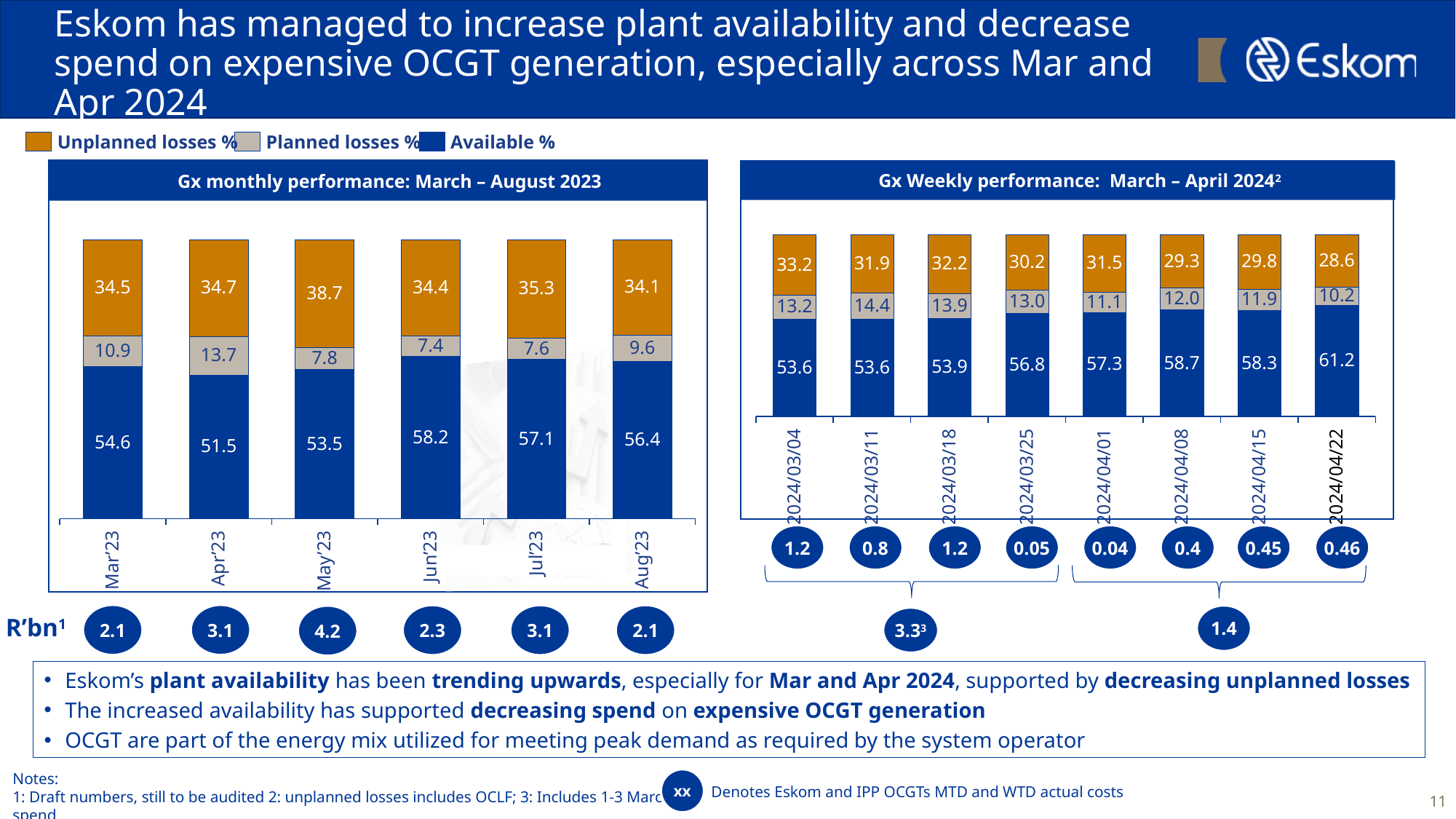
In the 'Gx Weekly performance: March – April 2024' chart, how many weeks are plotted? 8 In the 'Gx Weekly performance: March – April 2024' chart, what is the Available % value for 2024/04/22? 61.2 In the 'Gx Weekly performance: March – April 2024' chart, what is the Planned losses % value for 2024/03/11? 14.4 In the 'Gx monthly performance: March – August 2023' chart, which month has the lowest Available %? Apr'23 In the 'Gx monthly performance: March – August 2023' chart, what is the difference between the Available % for Jun'23 and Apr'23? 6.7 In the 'Gx monthly performance: March – August 2023' chart, which month has the highest Planned losses %? Apr'23 How many series does the legend list for the charts? 3 In the 'Gx monthly performance: March – August 2023' chart, what is the Available % value for Jun'23? 58.2 In the 'Gx monthly performance: March – August 2023' chart, what is the Unplanned losses % value for May'23? 38.7 In the 'Gx Weekly performance: March – April 2024' chart, is the Unplanned losses % larger for 2024/03/04 or 2024/04/08? 2024/03/04 What kind of chart is the 'Gx monthly performance: March – August 2023' chart? Stacked bar chart In the 'Gx Weekly performance: March – April 2024' chart, which week has the lowest Unplanned losses %? 2024/04/22